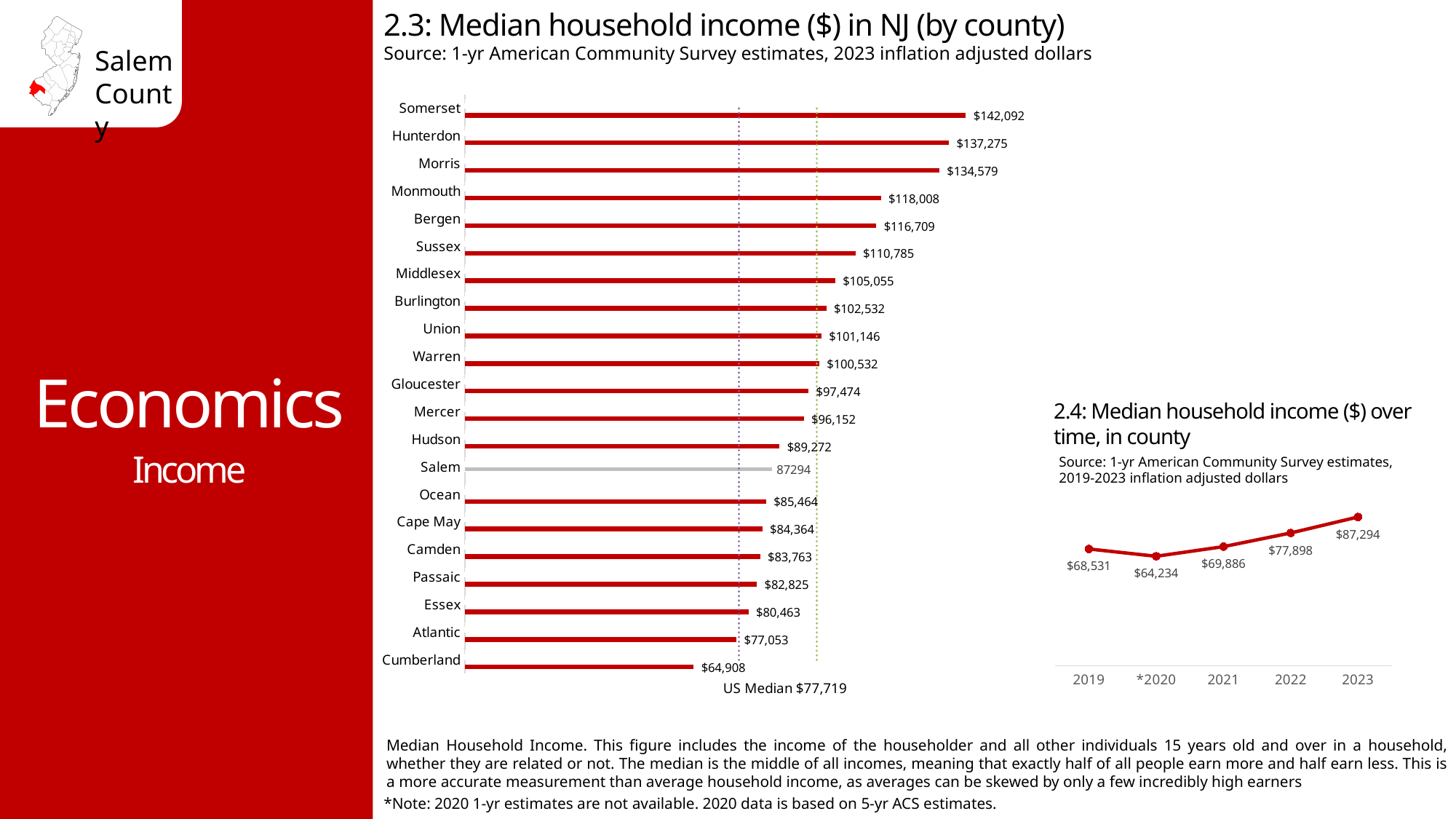
In chart 2.3 (Median household income in NJ by county), which county has the highest median household income? Somerset In chart 2.3 (Median household income in NJ by county), which has a higher median household income, Bergen or Sussex? Bergen In chart 2.3 (Median household income in NJ by county), what is the median household income for Somerset? $142,092 In chart 2.4 (Median household income over time, in county), which year has the lowest median household income? *2020 In chart 2.3 (Median household income in NJ by county), which county has the lowest median household income? Cumberland In chart 2.3 (Median household income in NJ by county), what value is shown for Salem? 87294 What type of chart is chart 2.3 (Median household income in NJ by county)? Bar chart In chart 2.3 (Median household income in NJ by county), what is the median household income for Gloucester? $97,474 In chart 2.4 (Median household income over time, in county), what is the median household income for 2021? $69,886 How many counties are shown in chart 2.3 (Median household income in NJ by county)? 21 In chart 2.3 (Median household income in NJ by county), what is the difference between Somerset's and Cumberland's median household income? $77,184 In chart 2.4 (Median household income over time, in county), what is the difference between the 2023 and 2019 values? $18,763